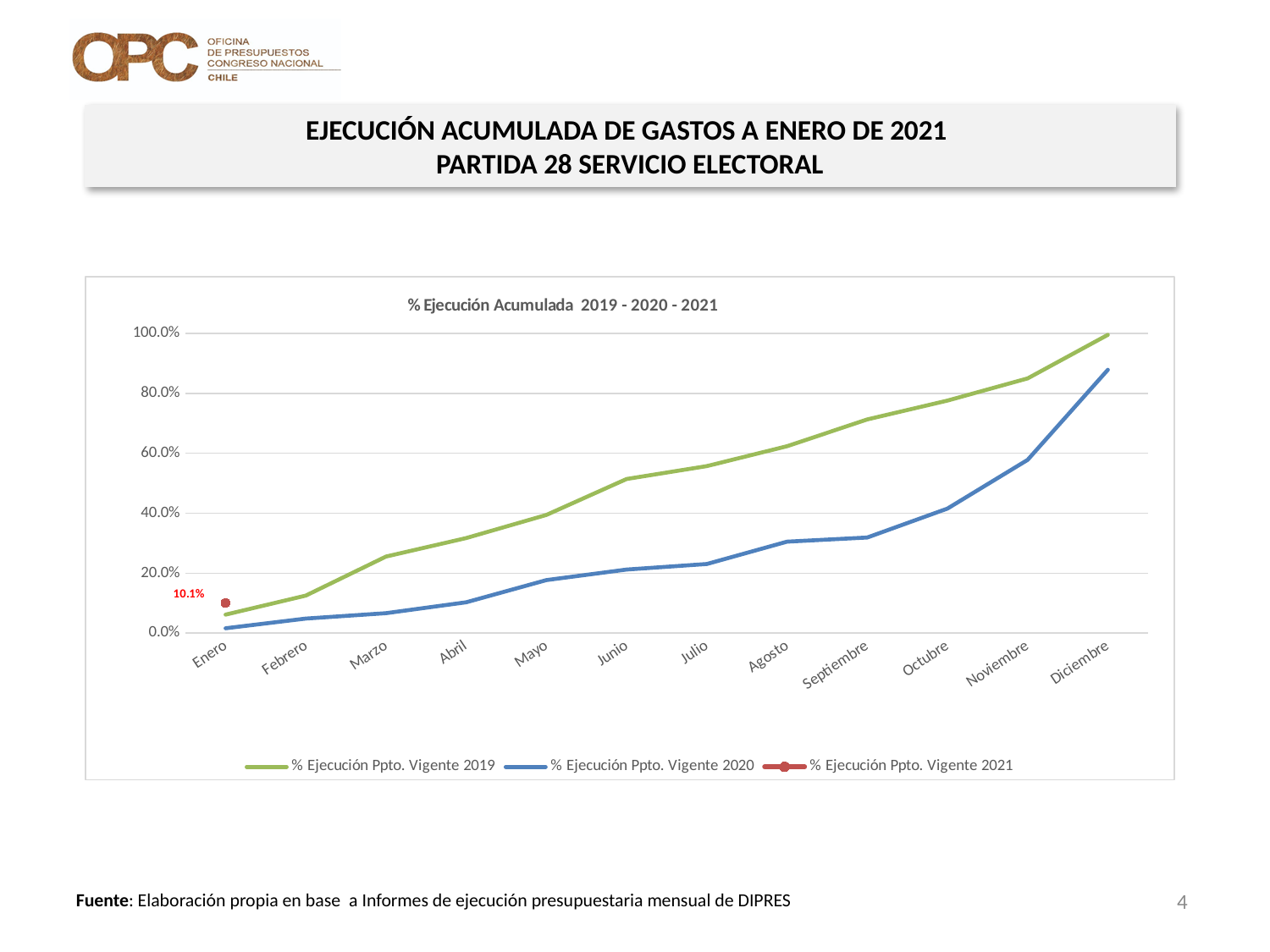
Is the value for % Ejecución Ppto. Vigente 2020 in Agosto greater or less than 40.0%? less What is the title of the chart? % Ejecución Acumulada 2019 - 2020 - 2021 Does the % Ejecución Ppto. Vigente 2019 line rise or fall from Enero to Diciembre? Rise In Enero, which series has the higher value: % Ejecución Ppto. Vigente 2021 or % Ejecución Ppto. Vigente 2020? % Ejecución Ppto. Vigente 2021 In Diciembre, which series has the higher value: % Ejecución Ppto. Vigente 2019 or % Ejecución Ppto. Vigente 2020? % Ejecución Ppto. Vigente 2019 What is the value of % Ejecución Ppto. Vigente 2021 for Enero? 10.1% How many months are shown on the x axis? 12 In which month does % Ejecución Ppto. Vigente 2019 reach its highest value? Diciembre How many series does the legend list? 3 Is the value for % Ejecución Ppto. Vigente 2019 in Junio greater or less than 40.0%? greater Is the value for % Ejecución Ppto. Vigente 2020 in Diciembre greater or less than 80.0%? greater What kind of chart is shown on the slide? Line chart